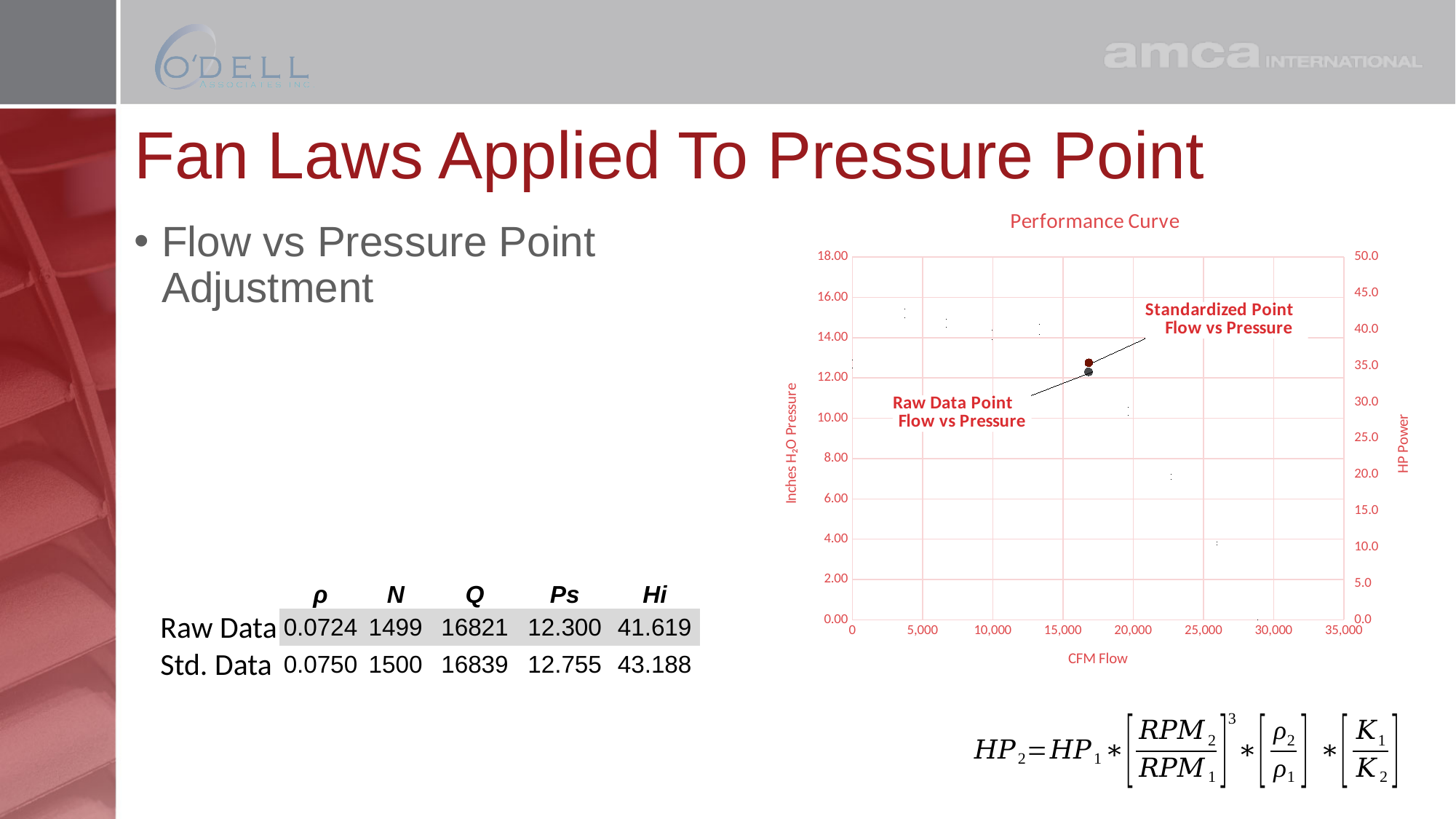
What is the x-axis title of the Performance Curve chart? CFM Flow How many labeled data points are called out on the Performance Curve chart? 2 On the Performance Curve chart, is the pressure of the Standardized Point greater or less than 12.00? greater On the Performance Curve chart, is the CFM Flow of the Raw Data Point greater or less than 15,000? greater On the Performance Curve chart, is the CFM Flow of the Standardized Point greater or less than 20,000? less What is the title of the chart on the slide? Performance Curve On the Performance Curve chart, which point has the higher pressure, the Raw Data Point or the Standardized Point? Standardized Point What type of chart is the Performance Curve chart? scatter chart